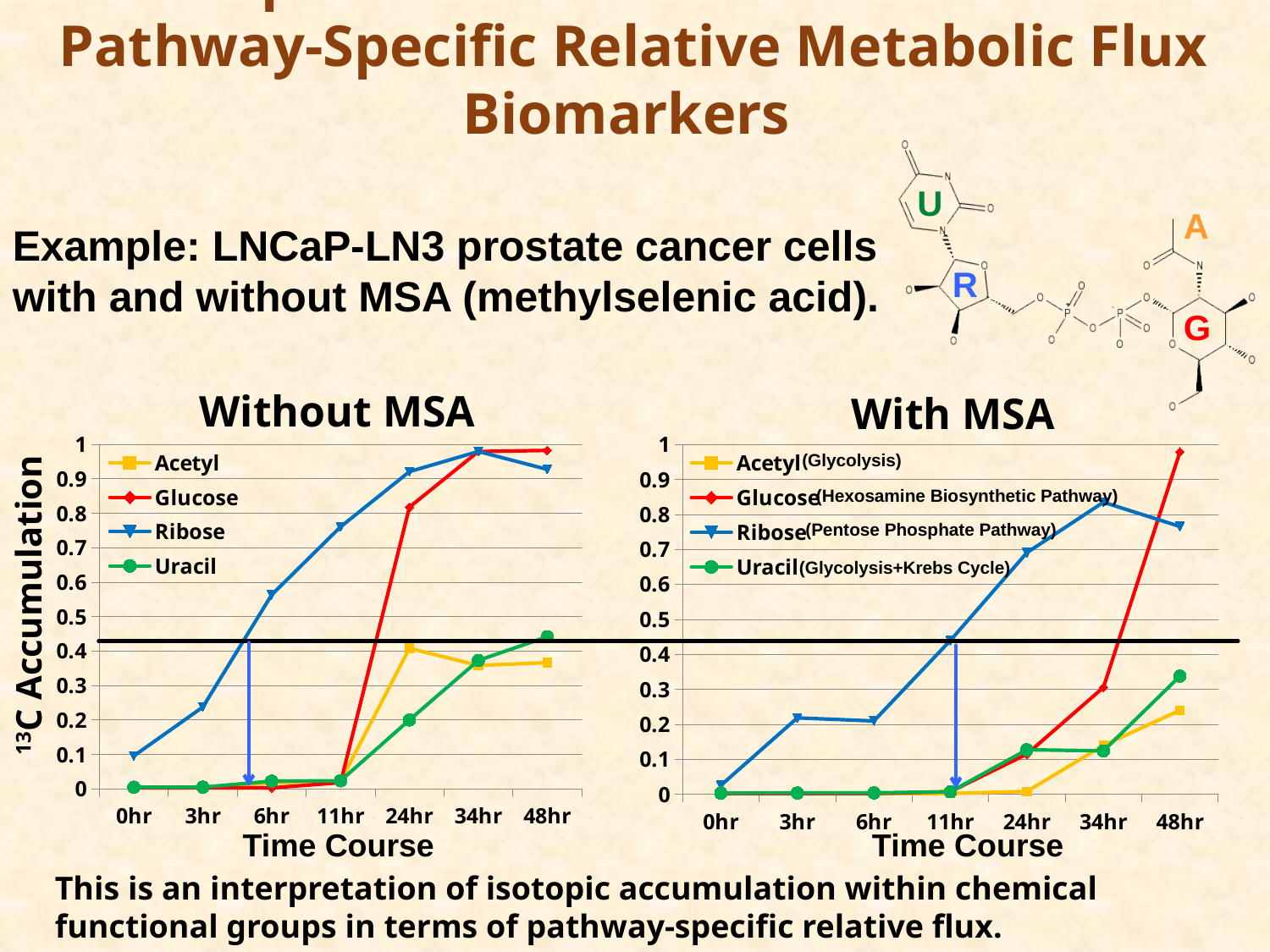
In the "Without MSA" chart, which is larger at 24hr, Ribose or Glucose? Ribose In the "Without MSA" chart, is the value for Glucose at 48hr greater or less than 0.9? greater In the "With MSA" chart, is the value for Ribose at 34hr greater or less than 0.7? greater In the "Without MSA" chart, is the value for Ribose at 6hr greater or less than 0.5? greater In the "With MSA" chart, which series has the highest value at 48hr? Glucose In the "With MSA" chart, which series has the lowest value at 48hr? Acetyl How many series does the legend of the "With MSA" chart list? 4 In the "With MSA" chart, does the Ribose series rise or fall between 34hr and 48hr? fall What is the y-axis label of the "Without MSA" chart? 13C Accumulation What kind of chart is the "Without MSA" chart? line chart How many time points are shown on the x axis of the "Without MSA" chart? 7